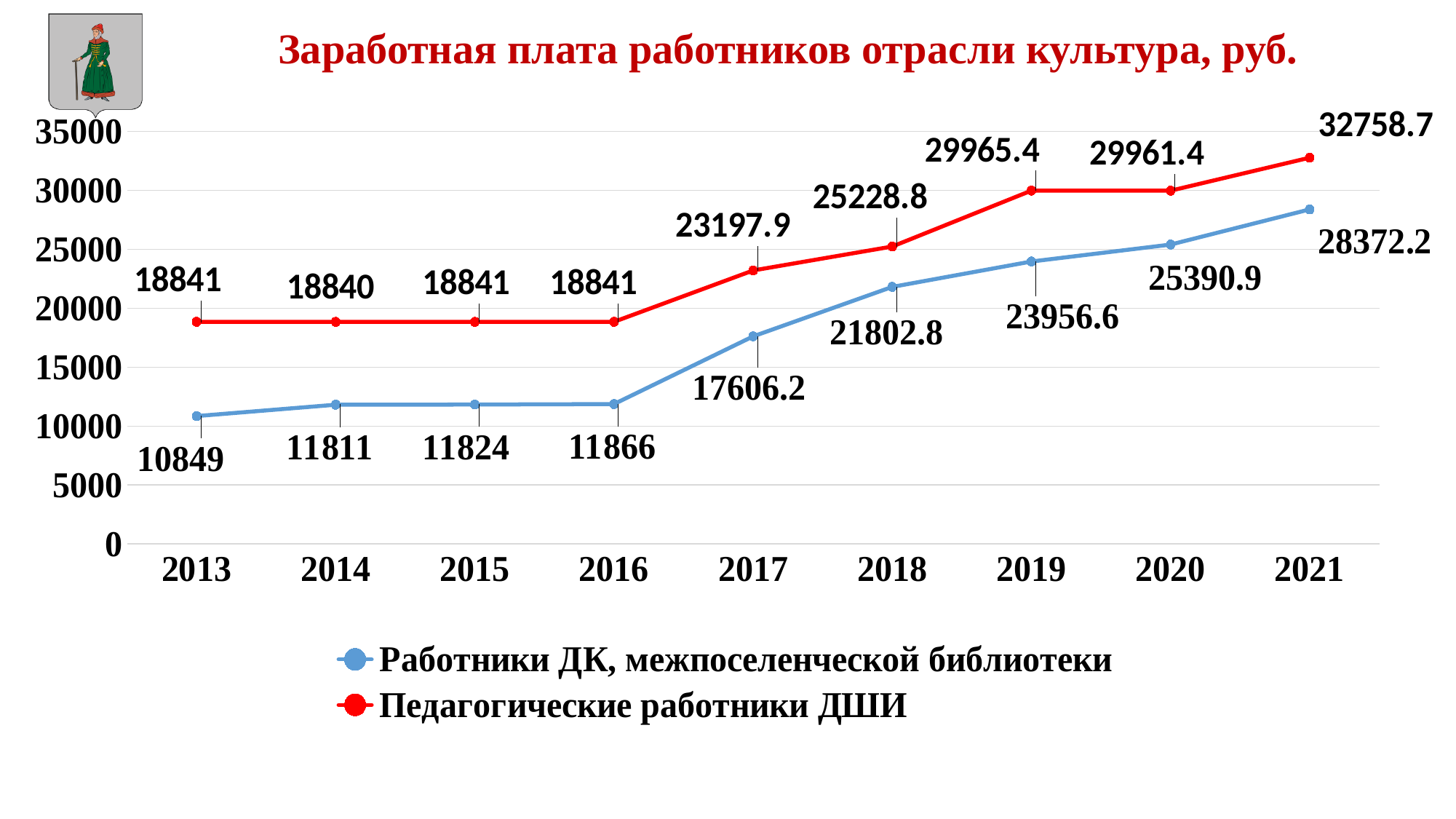
Do the values for Работники ДК, межпоселенческой библиотеки rise or fall from 2013 to 2021? Rise What is the difference between Педагогические работники ДШИ and Работники ДК, межпоселенческой библиотеки in 2021? 4386.5 What type of chart is shown on the slide? Line chart What is the value for Работники ДК, межпоселенческой библиотеки in 2017? 17606.2 In which year is the value for Педагогические работники ДШИ the highest? 2021 In which year is the value for Работники ДК, межпоселенческой библиотеки the lowest? 2013 How many years are shown on the x axis? 9 What is the value for Педагогические работники ДШИ in 2021? 32758.7 What is the value for Педагогические работники ДШИ in 2018? 25228.8 What is the value for Работники ДК, межпоселенческой библиотеки in 2013? 10849 How many series does the legend list? 2 Which series has the larger value in 2019: Работники ДК, межпоселенческой библиотеки or Педагогические работники ДШИ? Педагогические работники ДШИ